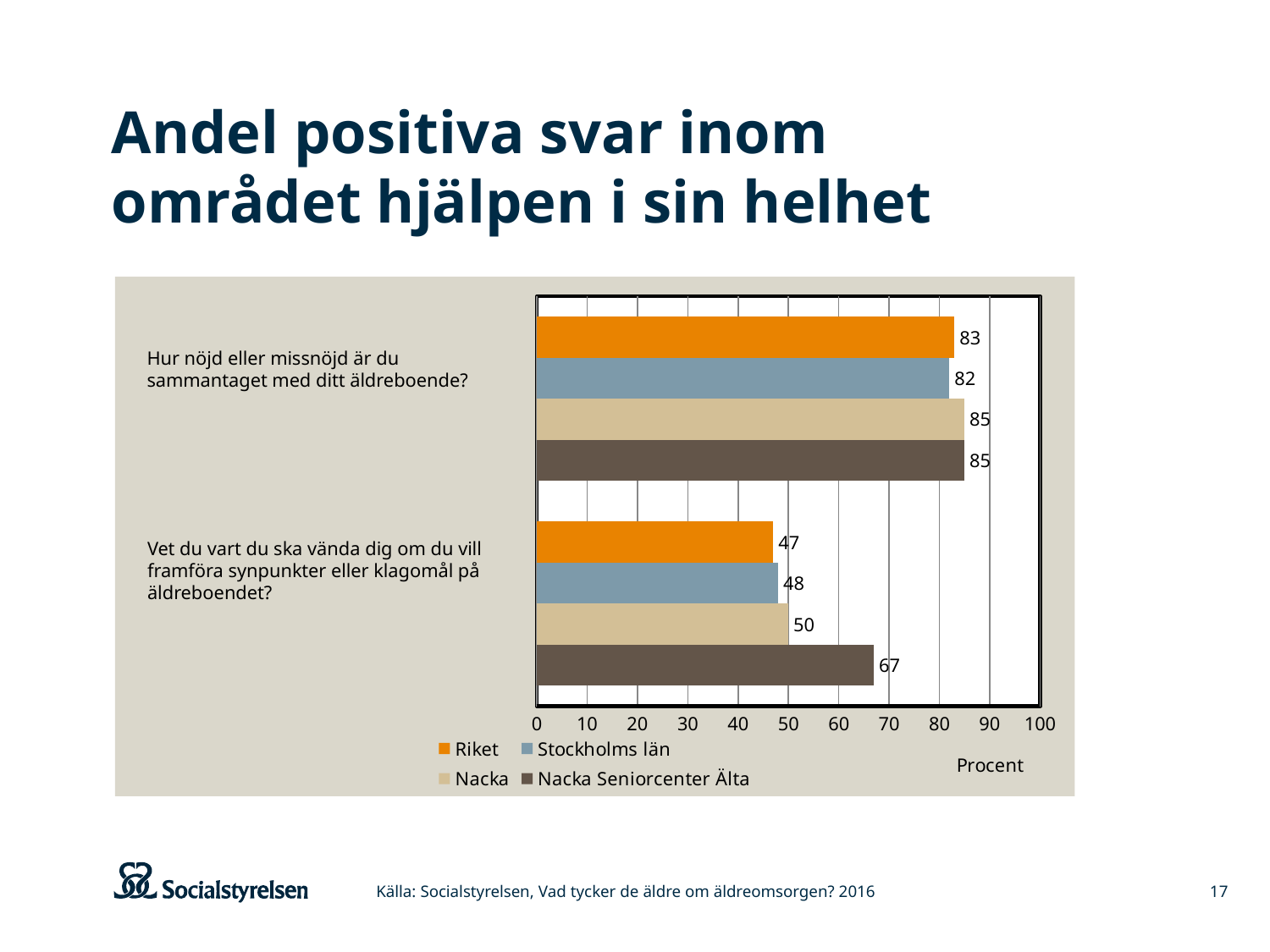
What is the value for Riket on the question "Hur nöjd eller missnöjd är du sammantaget med ditt äldreboende?"? 83 What kind of chart is shown on the slide? Bar chart Which series has the lowest value on the question "Hur nöjd eller missnöjd är du sammantaget med ditt äldreboende?"? Stockholms län What is the value for Nacka Seniorcenter Älta on the question "Vet du vart du ska vända dig om du vill framföra synpunkter eller klagomål på äldreboendet?"? 67 What colour are the bars for Riket? Orange Which is larger on the question "Hur nöjd eller missnöjd är du sammantaget med ditt äldreboende?": Riket or Nacka? Nacka Which series has the highest value on the question "Vet du vart du ska vända dig om du vill framföra synpunkter eller klagomål på äldreboendet?"? Nacka Seniorcenter Älta How many series does the legend list? 4 What is the difference between Nacka Seniorcenter Älta and Riket on the question "Vet du vart du ska vända dig om du vill framföra synpunkter eller klagomål på äldreboendet?"? 20 What is the value for Stockholms län on the question "Vet du vart du ska vända dig om du vill framföra synpunkter eller klagomål på äldreboendet?"? 48 How many questions (categories) are shown on the chart? 2 What is the label of the x axis? Procent